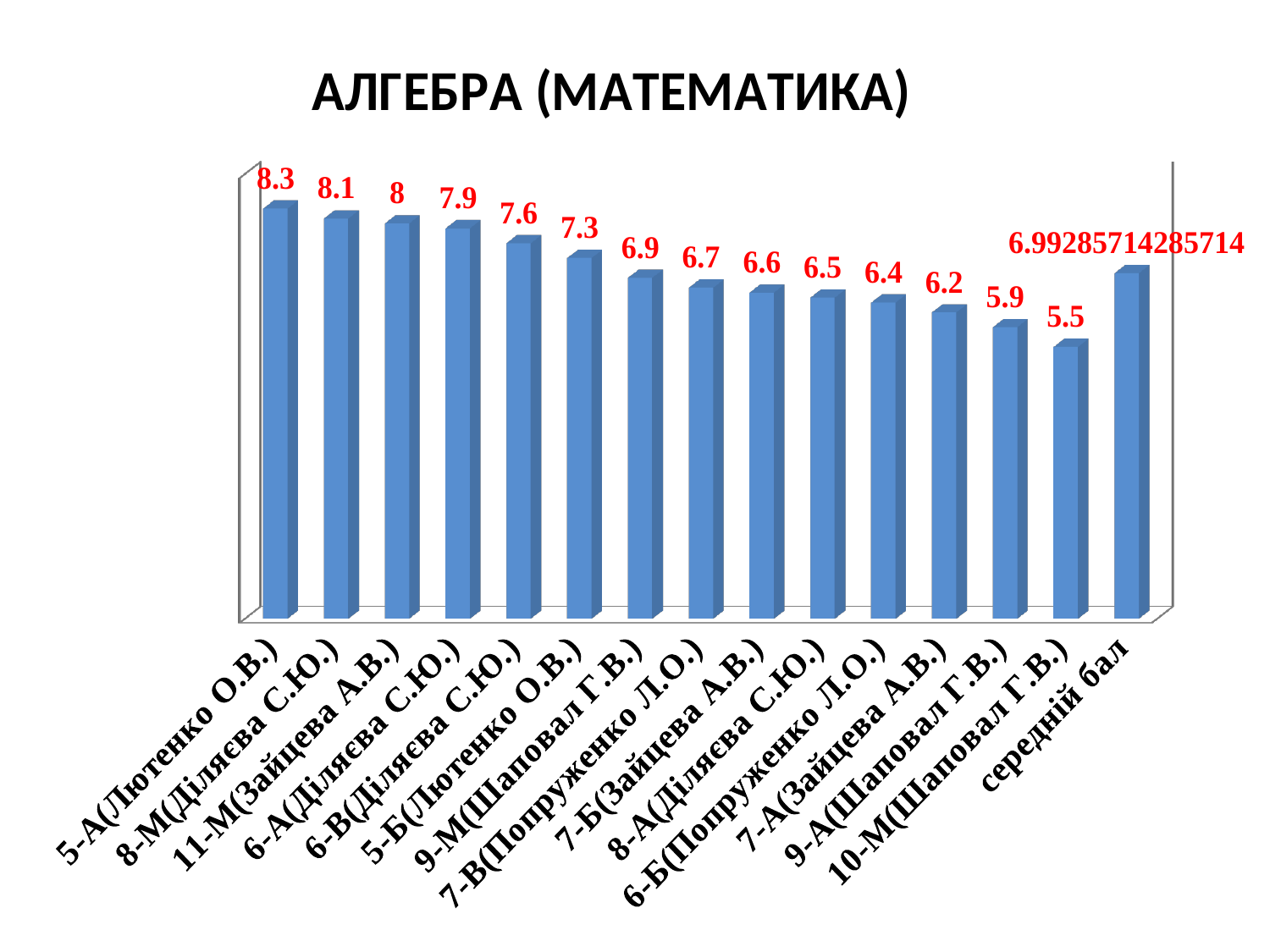
What is the difference between the values for 8-М(Діляєва С.Ю.) and 6-А(Діляєва С.Ю.)? 0.2 How many bars are plotted in the chart? 15 What is the title of the chart? АЛГЕБРА (МАТЕМАТИКА) What is the value for 5-А(Лютенко О.В.)? 8.3 What kind of chart is shown on the slide? Bar chart Which is larger, the value for 11-М(Зайцева А.В.) or the value for 9-А(Шаповал Г.В.)? 11-М(Зайцева А.В.) What is the difference between the values for 5-А(Лютенко О.В.) and 10-М(Шаповал Г.В.)? 2.8 Which category has the highest value? 5-А(Лютенко О.В.) What is the value shown for середній бал? 6.99285714285714 What is the value for 10-М(Шаповал Г.В.)? 5.5 Which category has the lowest value? 10-М(Шаповал Г.В.) What is the value for 7-В(Попруженко Л.О.)? 6.7